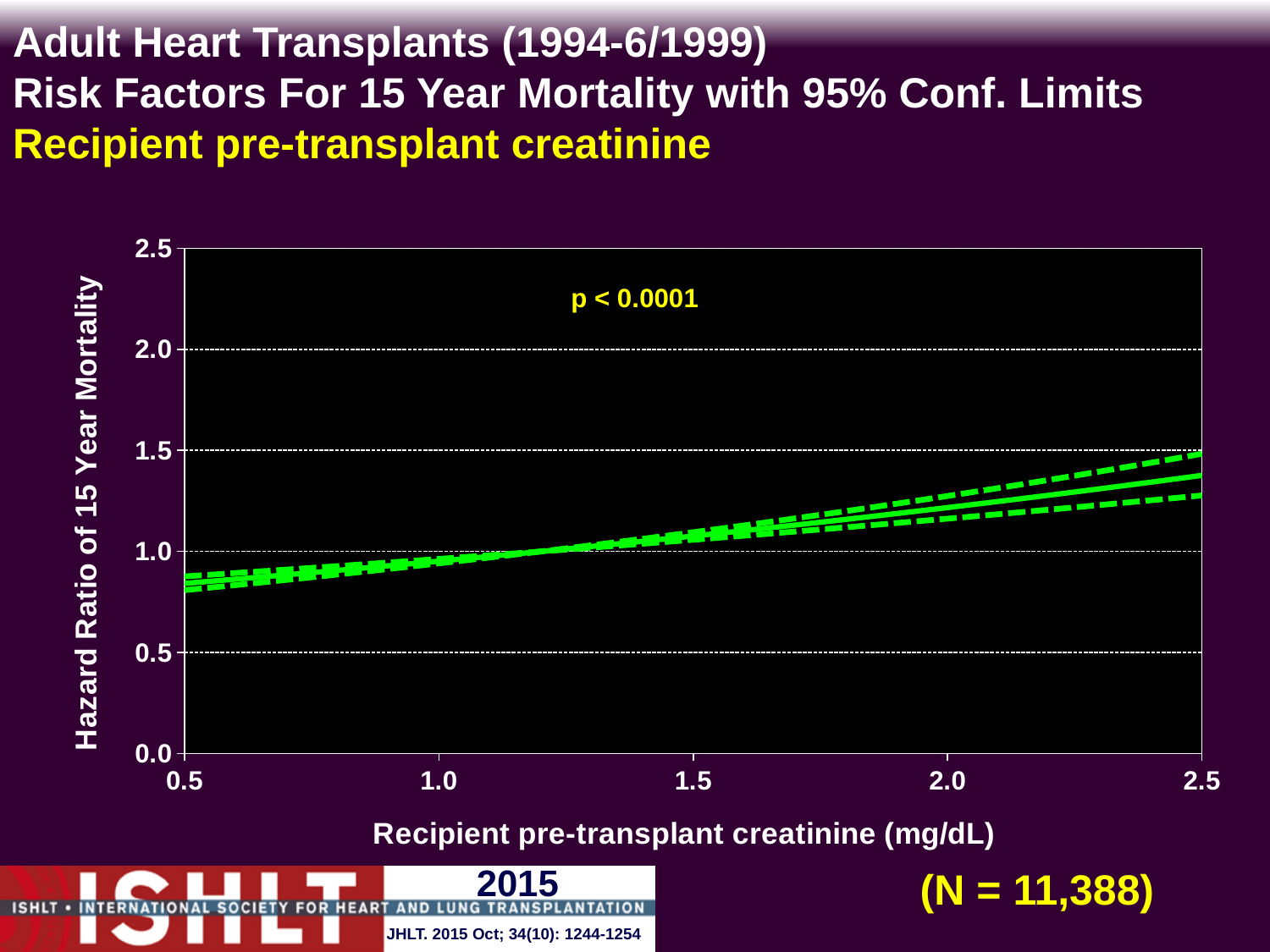
What kind of chart is shown on the slide? line chart What p-value is printed on the chart? p < 0.0001 Is the hazard ratio higher at a creatinine of 2.5 mg/dL or at 0.5 mg/dL? 2.5 mg/dL What is the highest value shown on the y axis of the chart? 2.5 Is the hazard ratio at a recipient pre-transplant creatinine of 1.5 mg/dL greater or less than 1.0? greater Is the hazard ratio at a recipient pre-transplant creatinine of 0.5 mg/dL greater or less than 1.0? less How many lines are plotted on the chart (the estimate plus its confidence limits)? 3 Is the hazard ratio at a recipient pre-transplant creatinine of 2.5 mg/dL greater or less than 1.5? less Does the hazard ratio rise or fall as recipient pre-transplant creatinine increases from 0.5 to 2.5 mg/dL? rise